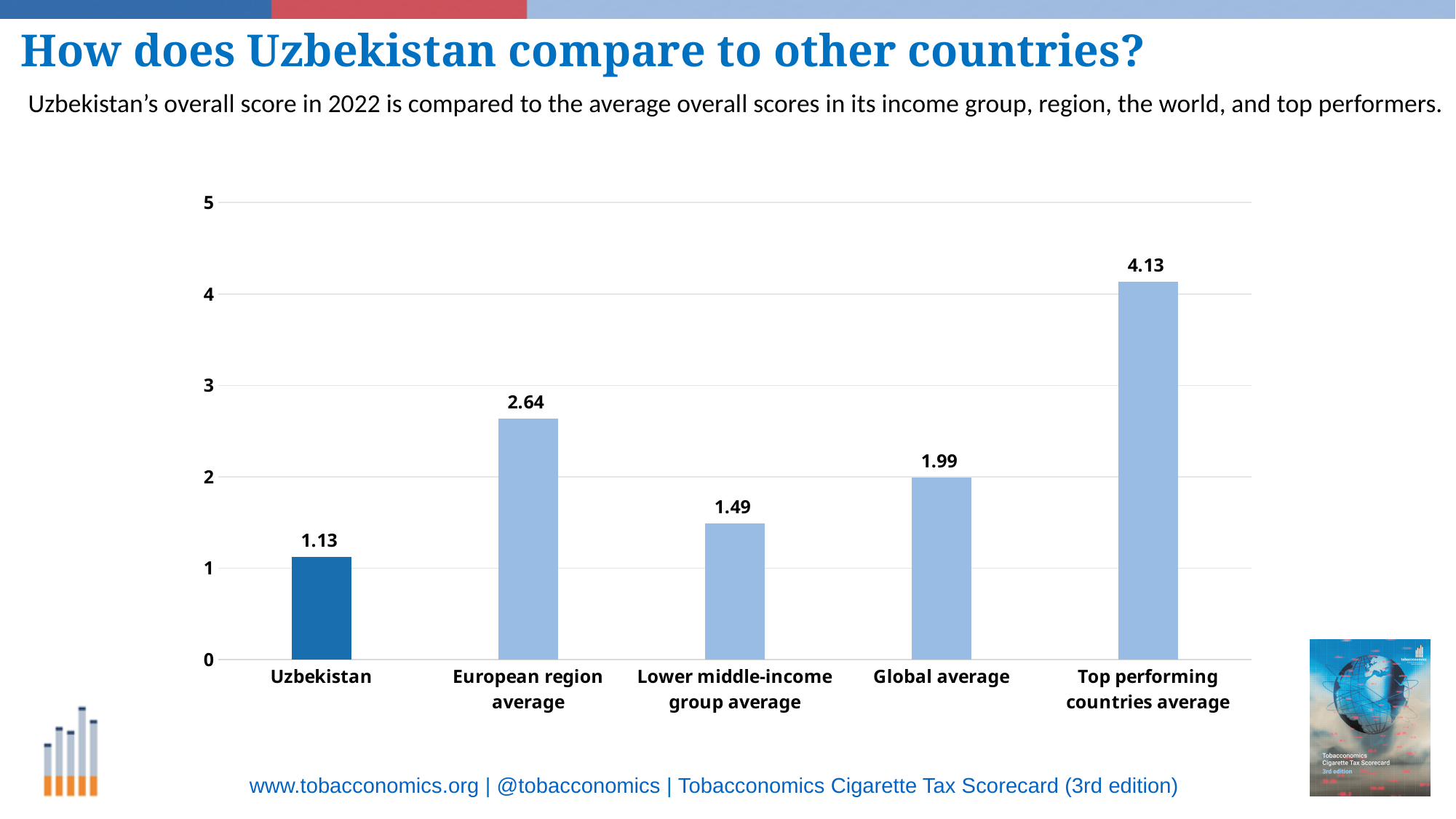
Which category has the highest value? Top performing countries average How many categories are shown in the chart? 5 What is the overall score for Uzbekistan? 1.13 What is the value for the Global average? 1.99 What is the difference between the European region average and the Global average? 0.65 Is the value for the Top performing countries average greater or less than 4? greater Which category has the lowest value? Uzbekistan Which is larger, the Global average or the Lower middle-income group average? Global average What is the difference between the Top performing countries average and Uzbekistan? 3.00 What is the value for the Lower middle-income group average? 1.49 What kind of chart is shown on the slide? Bar chart What is the value for the European region average? 2.64